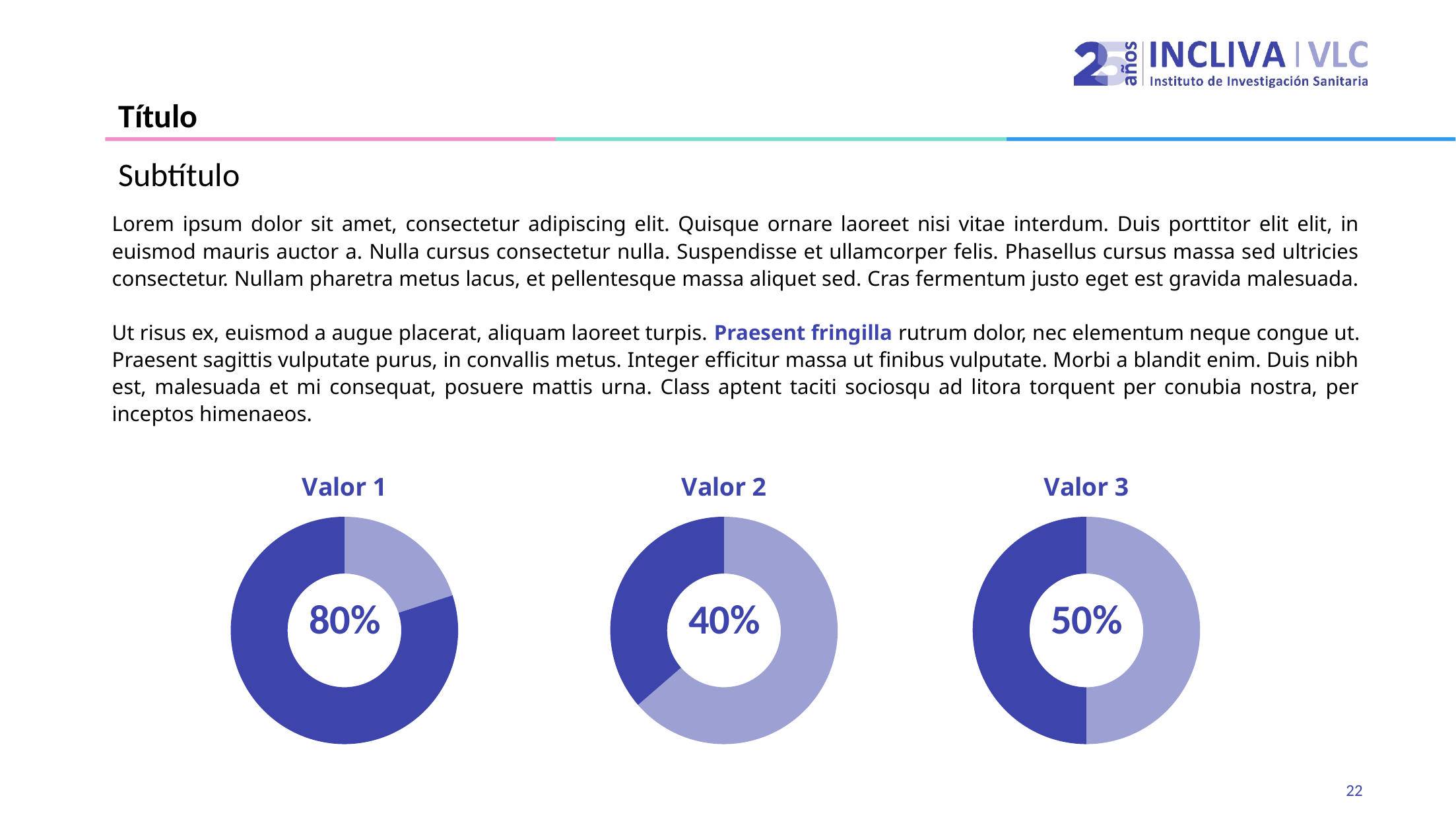
Which of the three charts (Valor 1, Valor 2, Valor 3) shows the lowest percentage? Valor 2 What value is shown in the centre of the Valor 1 chart? 80% What value is shown in the centre of the Valor 2 chart? 40% What is the difference between the percentage shown in the Valor 1 chart and the percentage shown in the Valor 2 chart? 40% What kind of chart is used for Valor 1, Valor 2 and Valor 3? Donut chart What value is shown in the centre of the Valor 3 chart? 50% What is the difference between the percentage shown in the Valor 3 chart and the percentage shown in the Valor 2 chart? 10% How many donut charts are shown on the slide? 3 In the Valor 3 chart, what share of the ring is filled with the darker blue colour? 50% Which shows a larger percentage, the Valor 2 chart or the Valor 3 chart? Valor 3 Which of the three charts (Valor 1, Valor 2, Valor 3) shows the highest percentage? Valor 1 Which shows a larger percentage, the Valor 1 chart or the Valor 3 chart? Valor 1